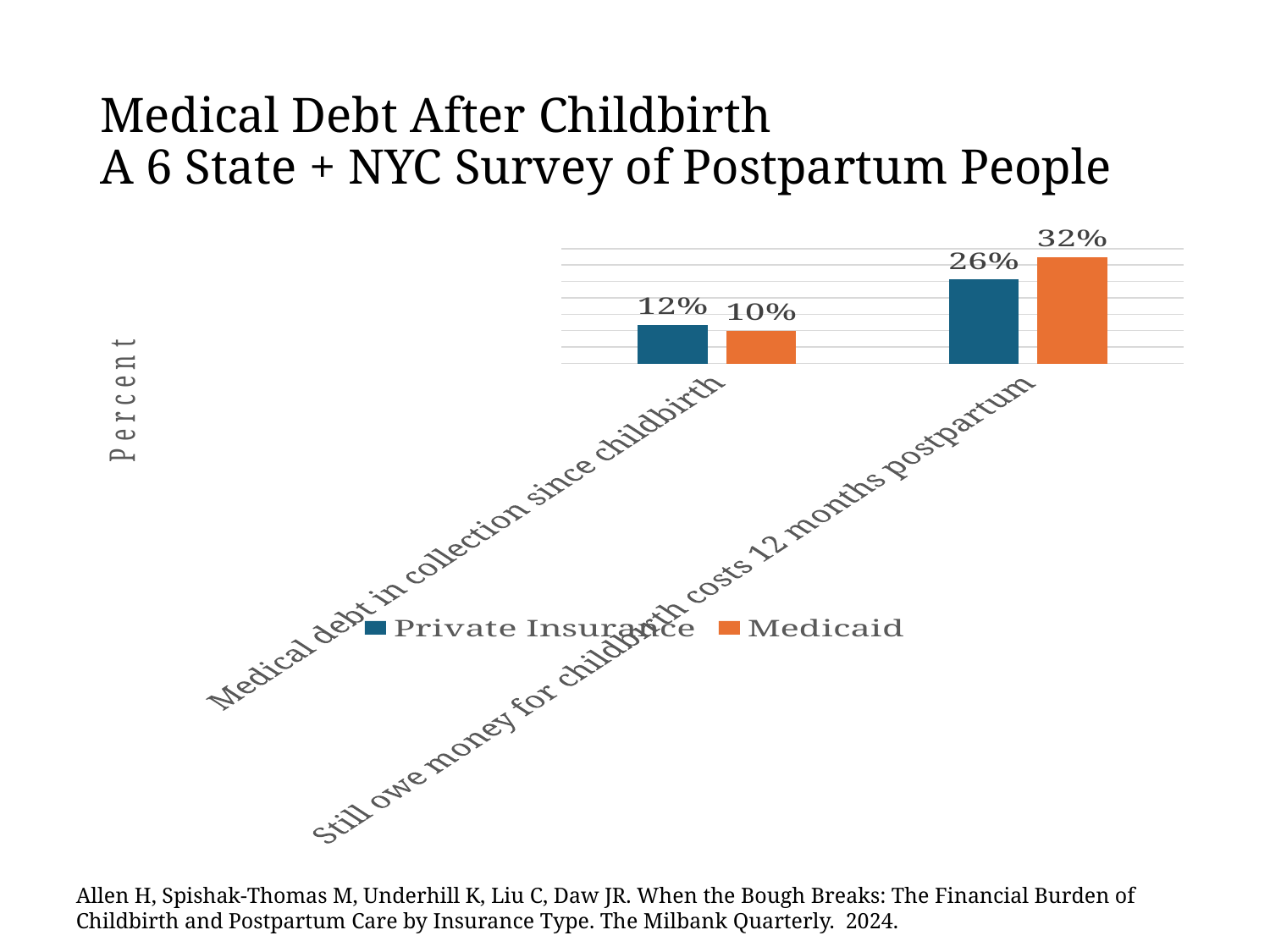
What is the difference between the Private Insurance and Medicaid values for medical debt in collection since childbirth? 2% What kind of chart is shown on the slide? Bar chart What percentage of people with Medicaid had medical debt in collection since childbirth? 10% What percentage of people with Private Insurance still owe money for childbirth costs 12 months postpartum? 26% Which bar in the chart has the highest value? Medicaid, still owe money for childbirth costs 12 months postpartum Which bar in the chart has the lowest value? Medicaid, medical debt in collection since childbirth For still owing money for childbirth costs 12 months postpartum, which group has the larger value, Private Insurance or Medicaid? Medicaid How many series does the legend list? 2 What is the difference between the Medicaid and Private Insurance values for still owing money for childbirth costs 12 months postpartum? 6% What percentage of people with Medicaid still owe money for childbirth costs 12 months postpartum? 32% How many categories are shown on the x axis? 2 What percentage of people with Private Insurance had medical debt in collection since childbirth? 12%